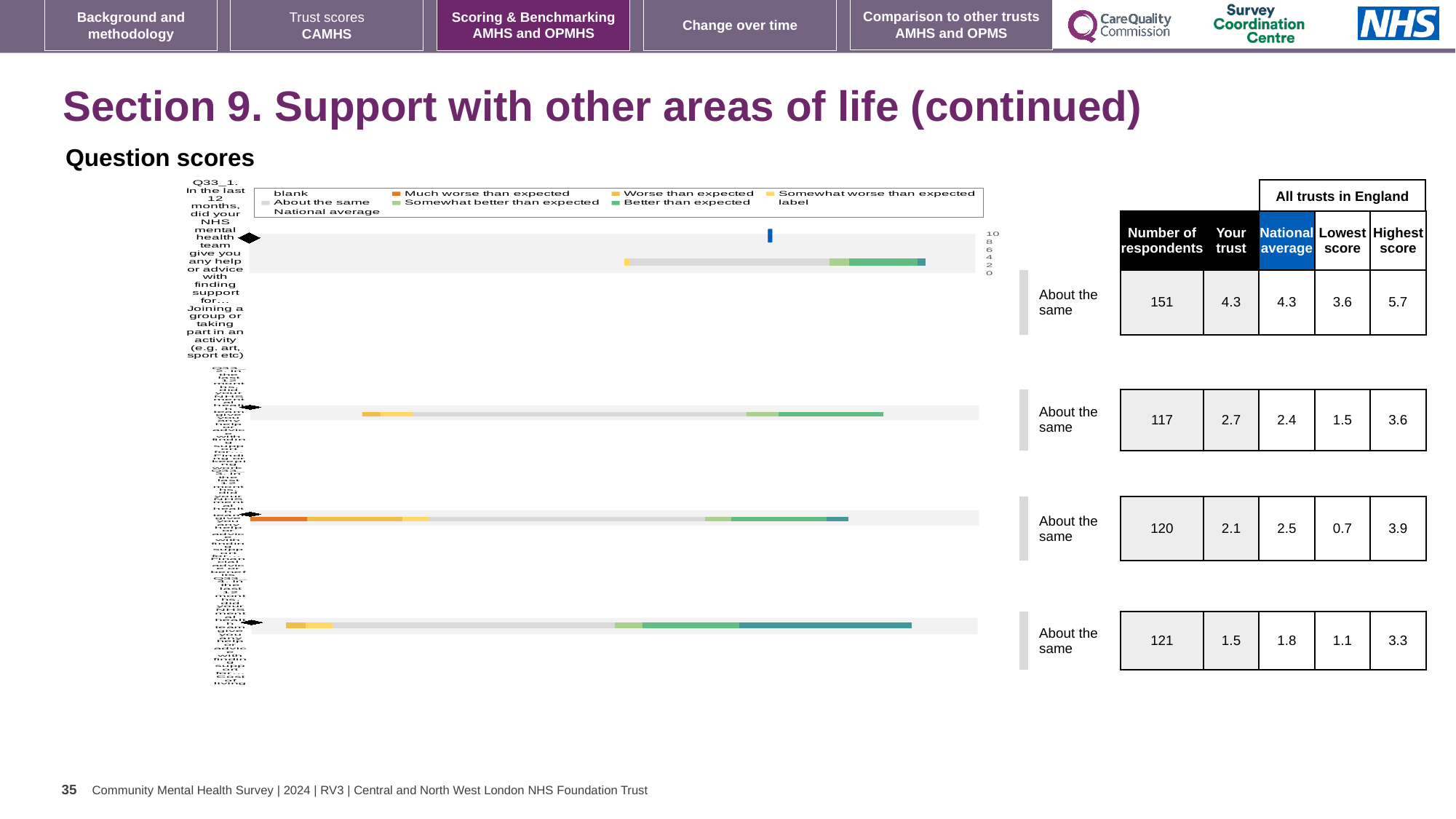
How many entries does the chart legend list? 9 What kind of chart is shown on the slide? Bar chart What is the 'Your trust' score for the first question (Joining a group or taking part in an activity)? 4.3 What is the smallest 'Lowest score' value shown across the four questions? 0.7 What comparison label is shown to the right of each bar in the chart? About the same How many respondents are listed for the first question (Joining a group or taking part in an activity)? 151 What is the difference between the highest score and the lowest score for the first question (Joining a group or taking part in an activity)? 2.1 How many question bars are plotted in the chart? 4 What is the national average for the fourth (bottom) question? 1.8 What colour is the 'Much worse than expected' legend entry? Orange Which question has the highest 'Your trust' score? The first question (Joining a group or taking part in an activity), 4.3 For the second question, which is larger: the 'Your trust' score or the national average? Your trust